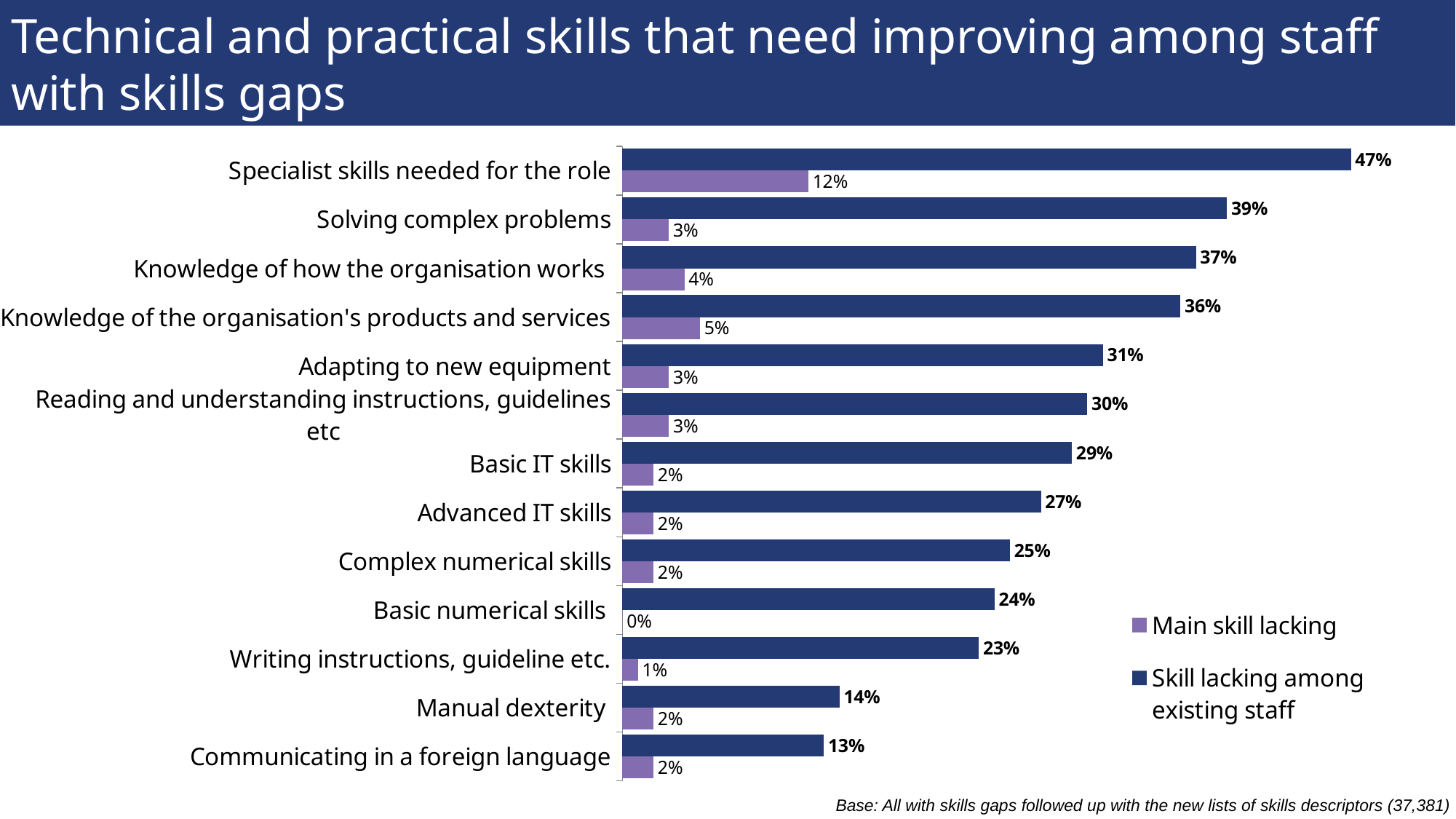
What is the value for 'Skill lacking among existing staff' for Basic IT skills? 29% What is the value for 'Main skill lacking' for Basic numerical skills? 0% Which category has the lowest value for 'Skill lacking among existing staff'? Communicating in a foreign language What is the value for 'Main skill lacking' for Knowledge of the organisation's products and services? 5% Which category has the highest value for 'Skill lacking among existing staff'? Specialist skills needed for the role What is the value for 'Skill lacking among existing staff' for Specialist skills needed for the role? 47% Which is larger for 'Skill lacking among existing staff': Advanced IT skills or Complex numerical skills? Advanced IT skills Which category has the highest value for 'Main skill lacking'? Specialist skills needed for the role What is the difference between the 'Skill lacking among existing staff' values for Solving complex problems and Manual dexterity? 25% How many series does the legend list? 2 What kind of chart is shown on the slide? Bar chart How many categories are shown on the chart? 13